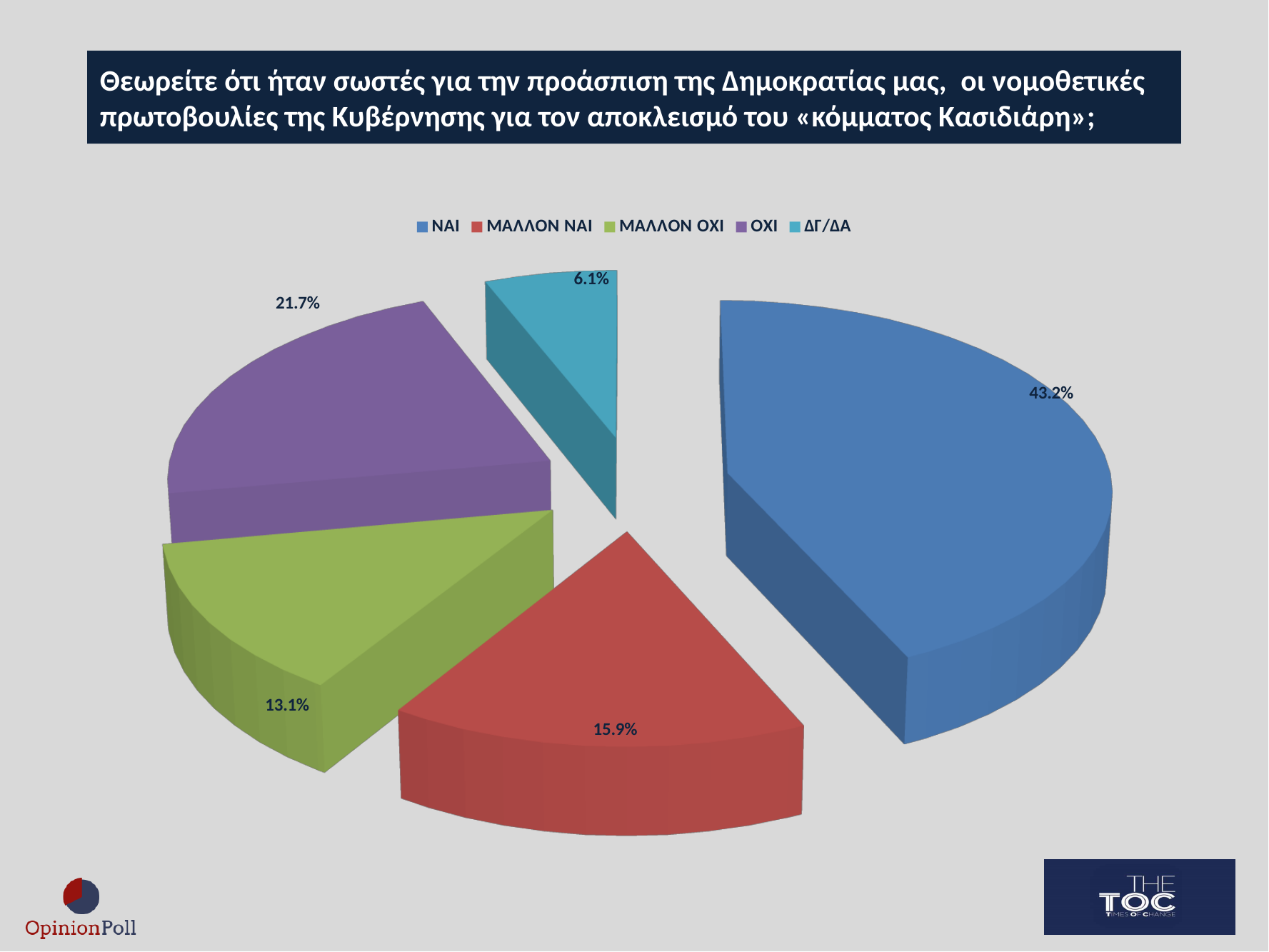
How many slices does the pie chart have? 5 Which category has the largest share of the pie? ΝΑΙ What type of chart is shown on the slide? pie chart What percentage is shown for ΜΑΛΛΟΝ ΟΧΙ? 13.1% What percentage is shown for ΜΑΛΛΟΝ ΝΑΙ? 15.9% Which is larger, the share for ΜΑΛΛΟΝ ΝΑΙ or the share for ΜΑΛΛΟΝ ΟΧΙ? ΜΑΛΛΟΝ ΝΑΙ What colour is the slice for ΟΧΙ? purple What is the difference in percentage points between ΝΑΙ and ΟΧΙ? 21.5 What percentage is shown for ΝΑΙ? 43.2% What percentage is shown for ΟΧΙ? 21.7% Which category has the smallest share of the pie? ΔΓ/ΔΑ What percentage is shown for ΔΓ/ΔΑ? 6.1%